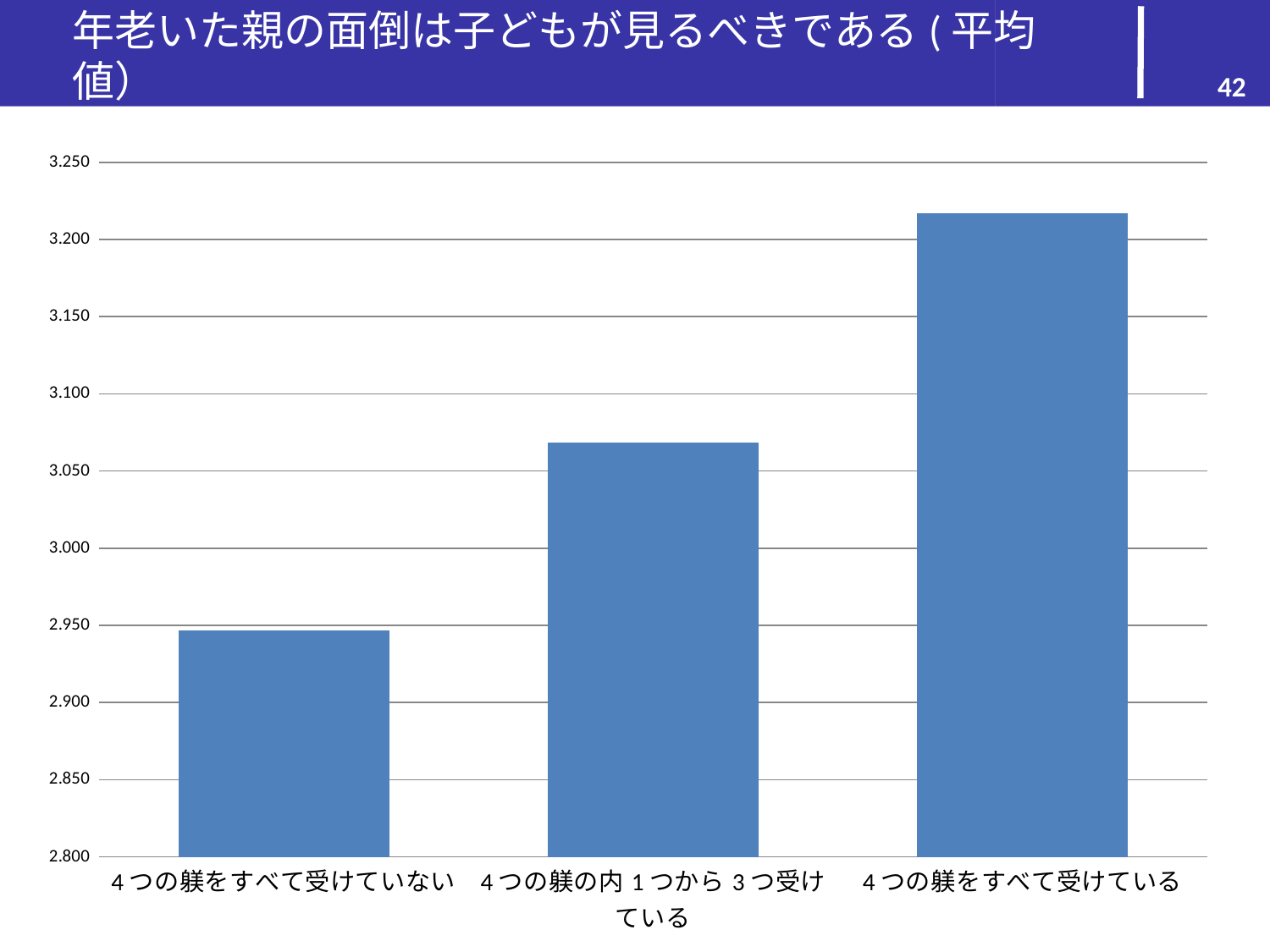
Is the value for ４つの躾をすべて受けていない greater or less than 3.000? less Is the value for ４つの躾をすべて受けている greater or less than 3.200? greater Which category has the lowest value? ４つの躾をすべて受けていない Do the values rise or fall from left to right across the categories? rise Is the value for ４つの躾の内１つから３つ受けている greater or less than 3.100? less Which is larger, the value for ４つの躾の内１つから３つ受けている or the value for ４つの躾をすべて受けていない? ４つの躾の内１つから３つ受けている How many categories are plotted in the chart? 3 What kind of chart is shown on the slide? bar chart Which category has the highest value? ４つの躾をすべて受けている What is the title of the slide containing the chart? 年老いた親の面倒は子どもが見るべきである（平均値）